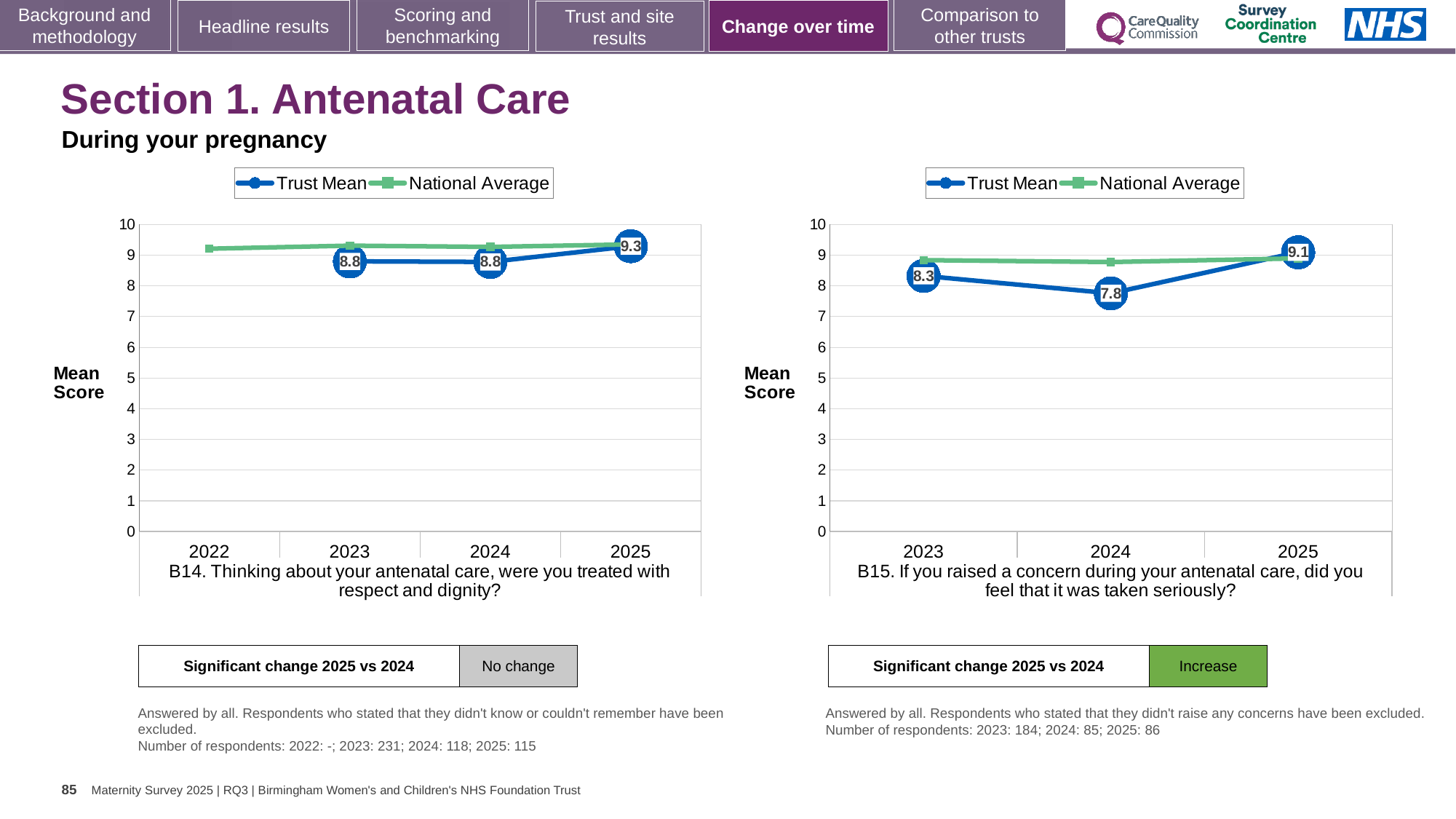
In the B14 chart (left), which year has the highest Trust Mean? 2025 In the B15 chart (right), is the National Average for 2023 greater or less than 8? greater How many series does the legend of the B14 chart (left) list? 2 In the B15 chart (right), what is the difference between the Trust Mean for 2025 and 2024? 1.3 In the B14 chart (left), is the Trust Mean for 2025 larger or smaller than the Trust Mean for 2024? larger In the B15 chart (right), what is the Trust Mean for 2024? 7.8 What type of chart is the B14 chart (left)? Line chart In the B14 chart (left), what is the Trust Mean for 2025? 9.3 In the B14 chart (left), what is the Trust Mean for 2023? 8.8 In the B15 chart (right), which year has the lowest Trust Mean? 2024 In the B15 chart (right), what is the Trust Mean for 2025? 9.1 How many years are shown on the x axis of the B15 chart (right)? 3